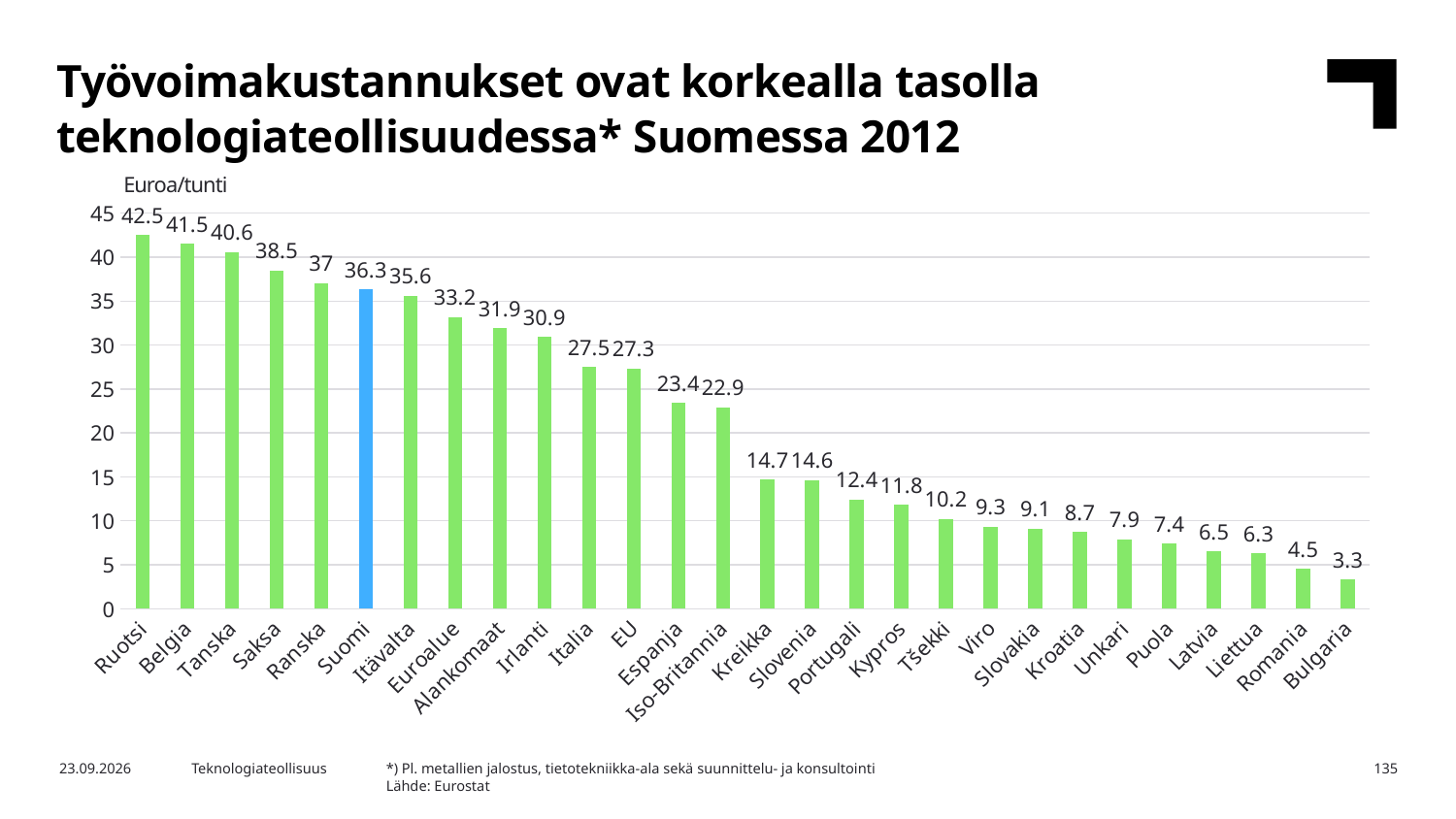
Which bar is coloured blue instead of green? Suomi Do the values rise or fall from left to right along the x axis? Fall What is the difference between the values for Espanja and Iso-Britannia? 0.5 Which country has the lowest labour cost per hour? Bulgaria What kind of chart is shown on the slide? Bar chart What is the value for Viro? 9.3 What is the value for Suomi? 36.3 Which country has the highest labour cost per hour? Ruotsi How many categories are shown on the x axis? 28 What is the value for Euroalue? 33.2 What is the difference between the values for Ruotsi and Suomi? 6.2 Which is larger, the value for Saksa or the value for Ranska? Saksa